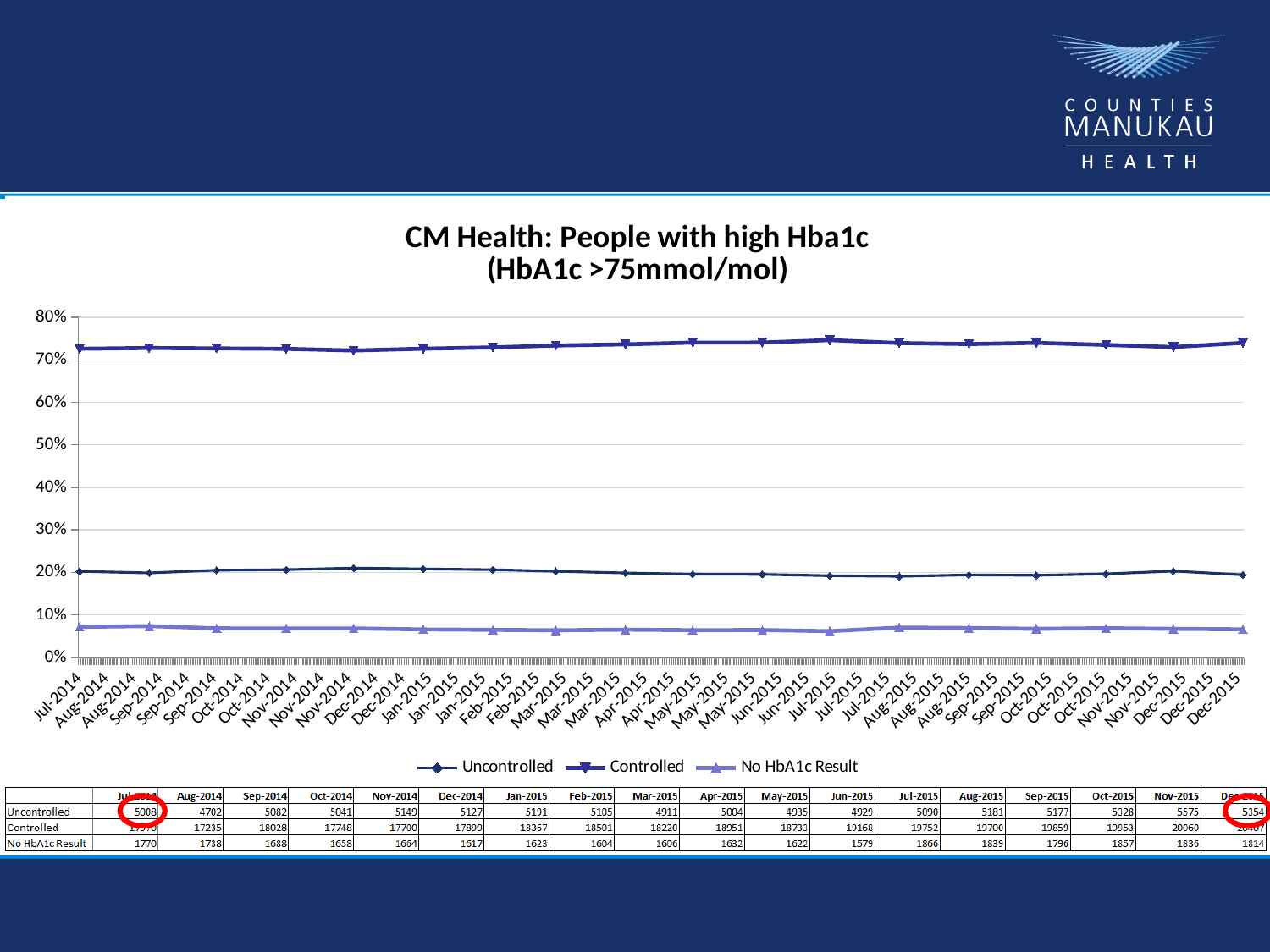
What are the three series named in the legend? Uncontrolled, Controlled, No HbA1c Result In Mar-2015, which series has the larger value, Controlled or Uncontrolled? Controlled What kind of chart is shown on the slide? line chart According to the data table below the chart, what is the difference between the Uncontrolled counts for Nov-2015 and Oct-2015? 247 According to the data table below the chart, in which month is the Uncontrolled count highest? Nov-2015 How many series does the legend list? 3 According to the data table below the chart, what is the No HbA1c Result count for Jun-2015? 1579 According to the data table below the chart, what is the Controlled count for Nov-2015? 20060 Is the value for Uncontrolled in Dec-2014 greater or less than 30%? less According to the data table below the chart, what is the Uncontrolled count for Aug-2014? 4702 Is the value for No HbA1c Result in Mar-2015 greater or less than 10%? less Is the value for Controlled in Jul-2014 greater or less than 70%? greater